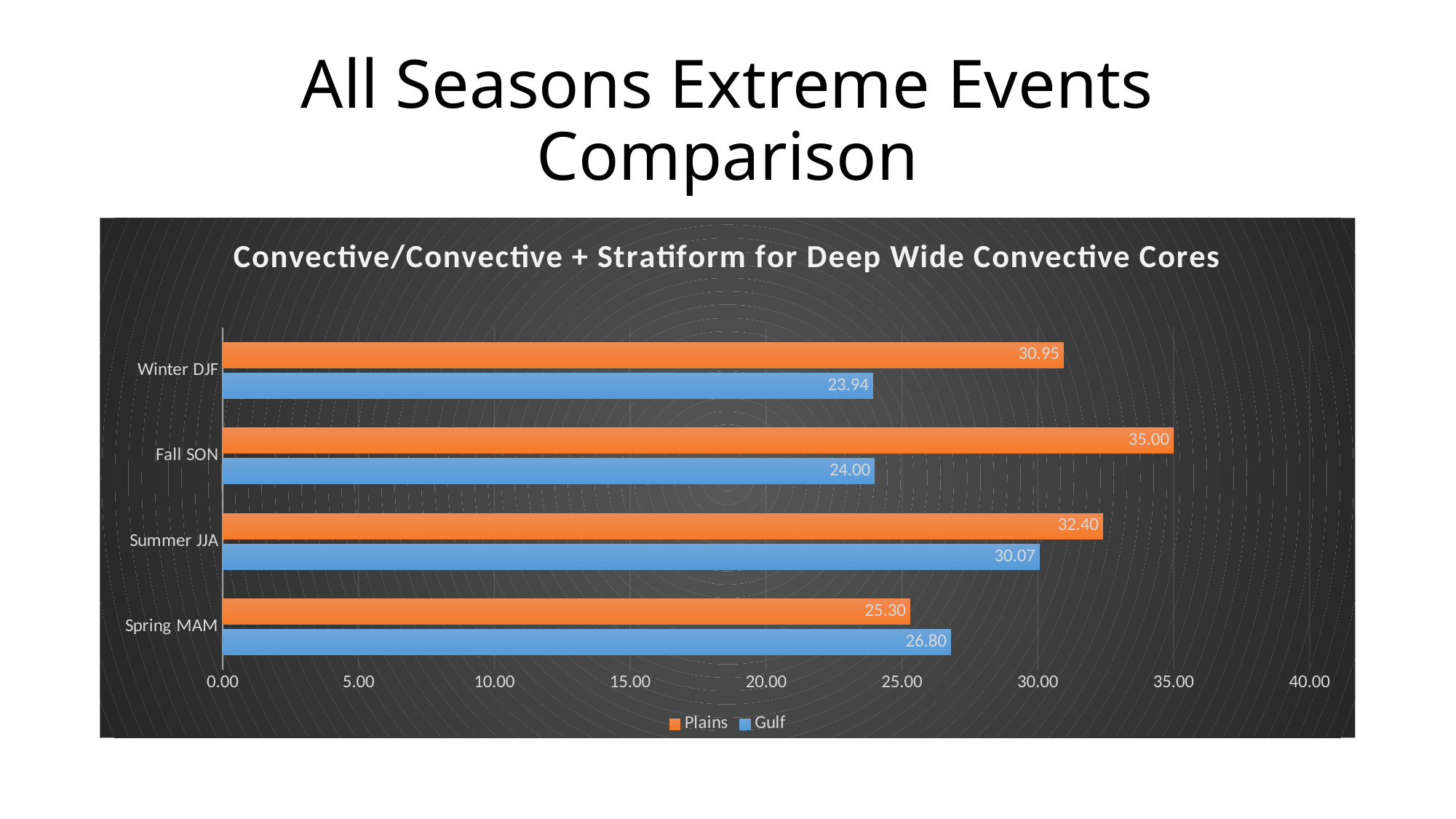
What is the Gulf value for Spring MAM? 26.80 What is the Gulf value for Winter DJF? 23.94 Is the Gulf value for Summer JJA greater or less than 25.00? greater What is the Plains value for Fall SON? 35.00 What is the title of the chart? Convective/Convective + Stratiform for Deep Wide Convective Cores Which season has the highest Plains value? Fall SON How many seasons are shown on the chart? 4 What is the difference between the Plains and Gulf values for Fall SON? 11.00 Which season has the lowest Gulf value? Winter DJF Which is larger for Spring MAM, the Plains value or the Gulf value? Gulf What kind of chart is shown on the slide? bar chart How many series does the legend list? 2